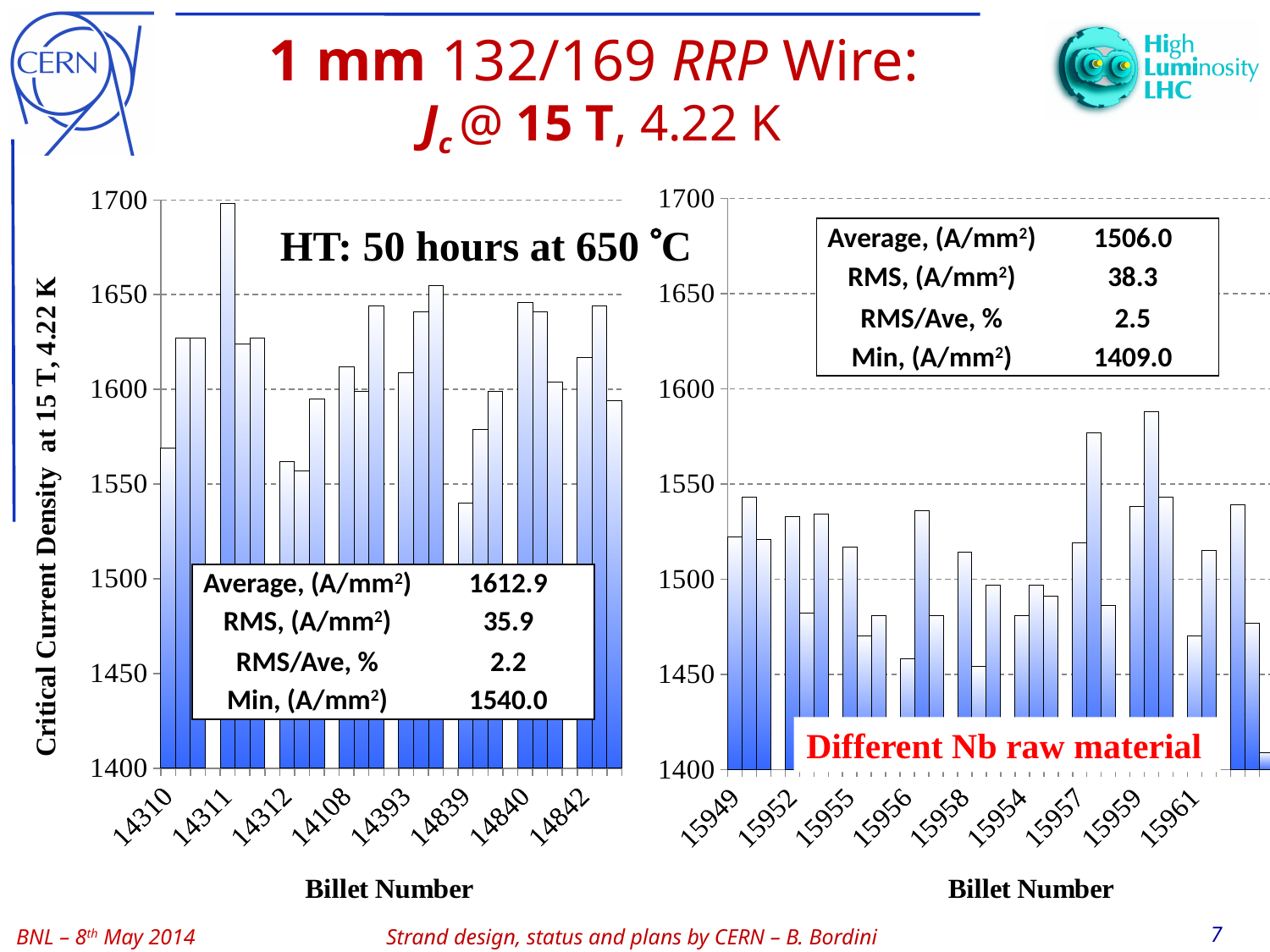
In the right chart, is the tallest bar greater or less than 1600? less What annotation text is printed in red on the right chart? Different Nb raw material How many billet numbers are labelled on the x axis of the left chart? 8 In the left chart, is the tallest bar greater or less than 1650? greater What kind of chart is the left chart on the slide? bar chart What is the x-axis title of the left chart? Billet Number In the right chart, is the tallest bar greater or less than 1550? greater What kind of chart is the right chart on the slide? bar chart Which chart has the taller maximum bar, the left chart or the right chart? the left chart How many billet numbers are labelled on the x axis of the right chart? 9